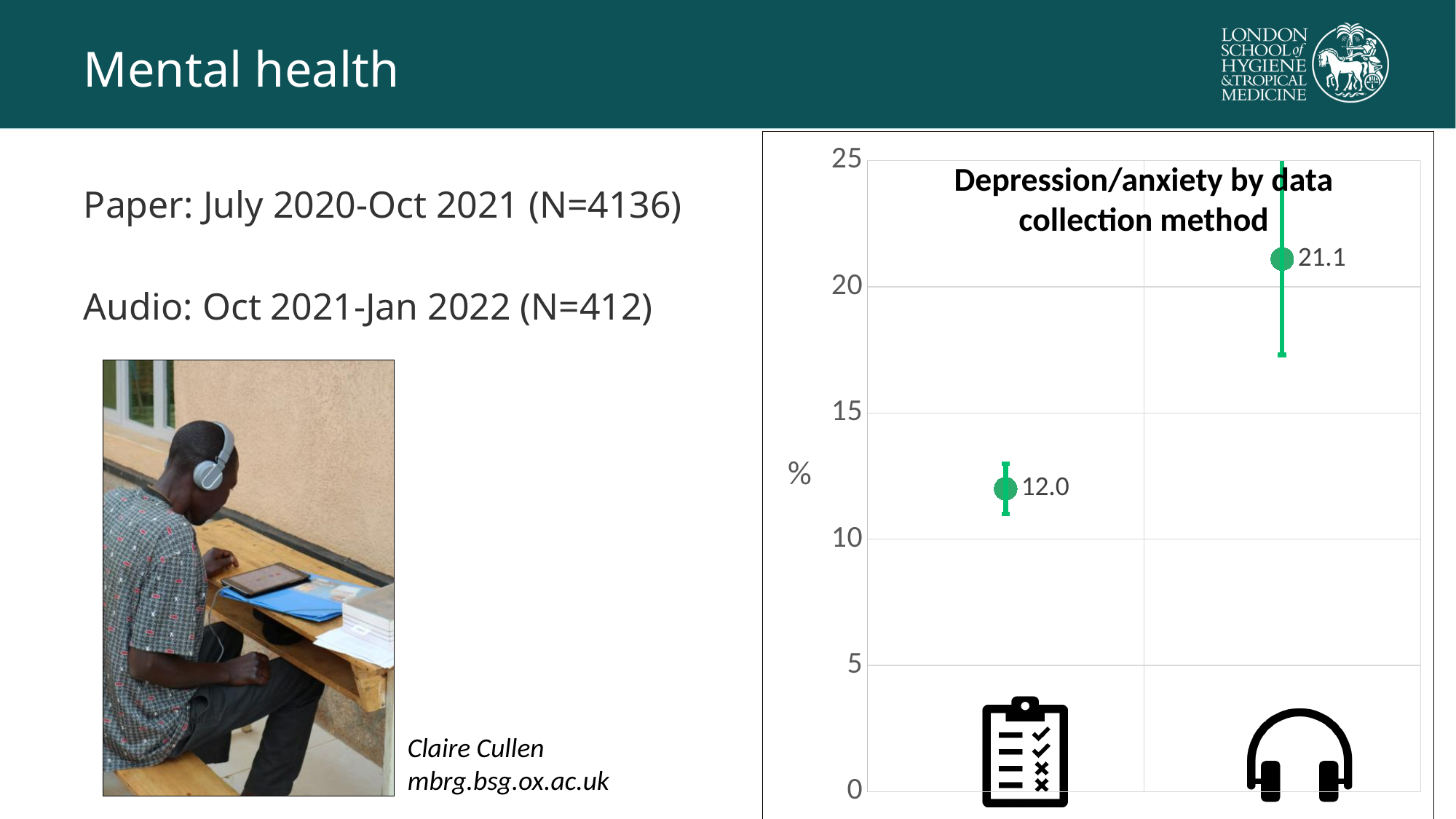
What is the label on the vertical axis of the chart? % Is the value for the audio (headphones icon) method greater or less than 20? greater What is the title of the chart? Depression/anxiety by data collection method Is the value for audio (headphones icon) larger or smaller than the value for paper (clipboard icon)? larger Which data collection method has the higher depression/anxiety value? Audio (headphones icon) What is the value for the audio (headphones icon) data collection method? 21.1 What is the difference between the audio value and the paper value? 9.1 What is the maximum value shown on the vertical axis of the chart? 25 Is the value for the paper (clipboard icon) method greater or less than 15? less How many data collection methods are plotted on the chart? 2 What is the value for the paper (clipboard icon) data collection method? 12.0 Which data collection method has the lower depression/anxiety value? Paper (clipboard icon)